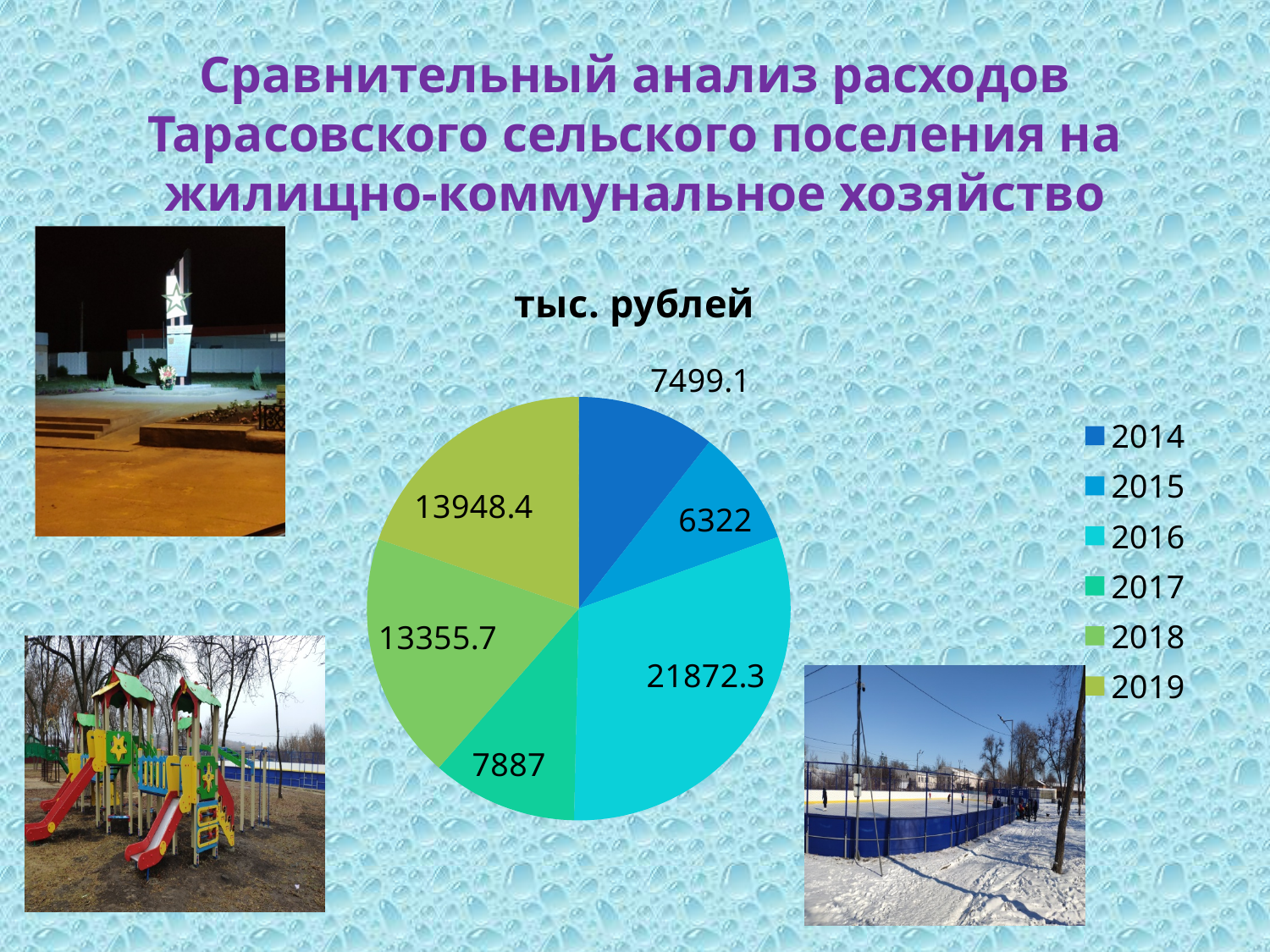
What is the value for 2018 in the pie chart? 13355.7 What is the difference between the values for 2019 and 2018? 592.7 How many entries does the legend list? 6 What is the title of the chart? тыс. рублей Which year has the smallest slice in the pie chart? 2015 How many slices does the pie chart have? 6 What is the difference between the values for 2016 and 2015? 15550.3 Which is larger, the value for 2017 or the value for 2014? 2017 Which year has the largest slice in the pie chart? 2016 What is the value for 2014 in the pie chart? 7499.1 What is the value for 2016 in the pie chart? 21872.3 What kind of chart is shown on the slide? pie chart